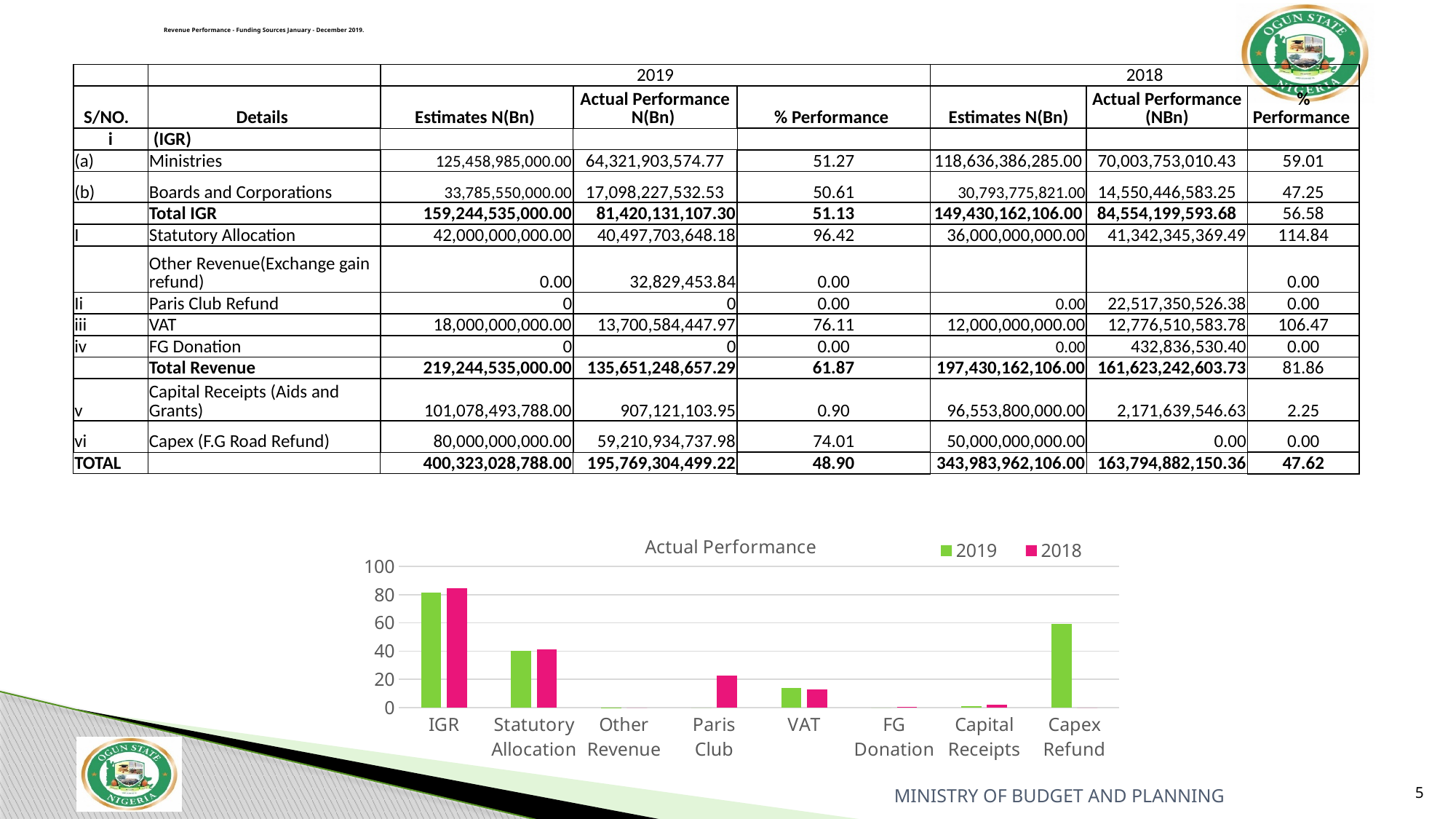
For Capex Refund, which series has the larger value, 2019 or 2018? 2019 What kind of chart is shown on the slide? bar chart What is the title of the chart on the slide? Actual Performance Is the 2019 value for Statutory Allocation greater or less than 60? less For Paris Club, which series has the larger value, 2019 or 2018? 2018 Is the 2018 value for Paris Club greater or less than 40? less How many categories are shown on the x axis of the chart? 8 Which category has the highest 2018 value in the chart? IGR How many series does the chart legend list? 2 Is the 2019 value for IGR greater or less than 60? greater Which category has the highest 2019 value in the chart? IGR